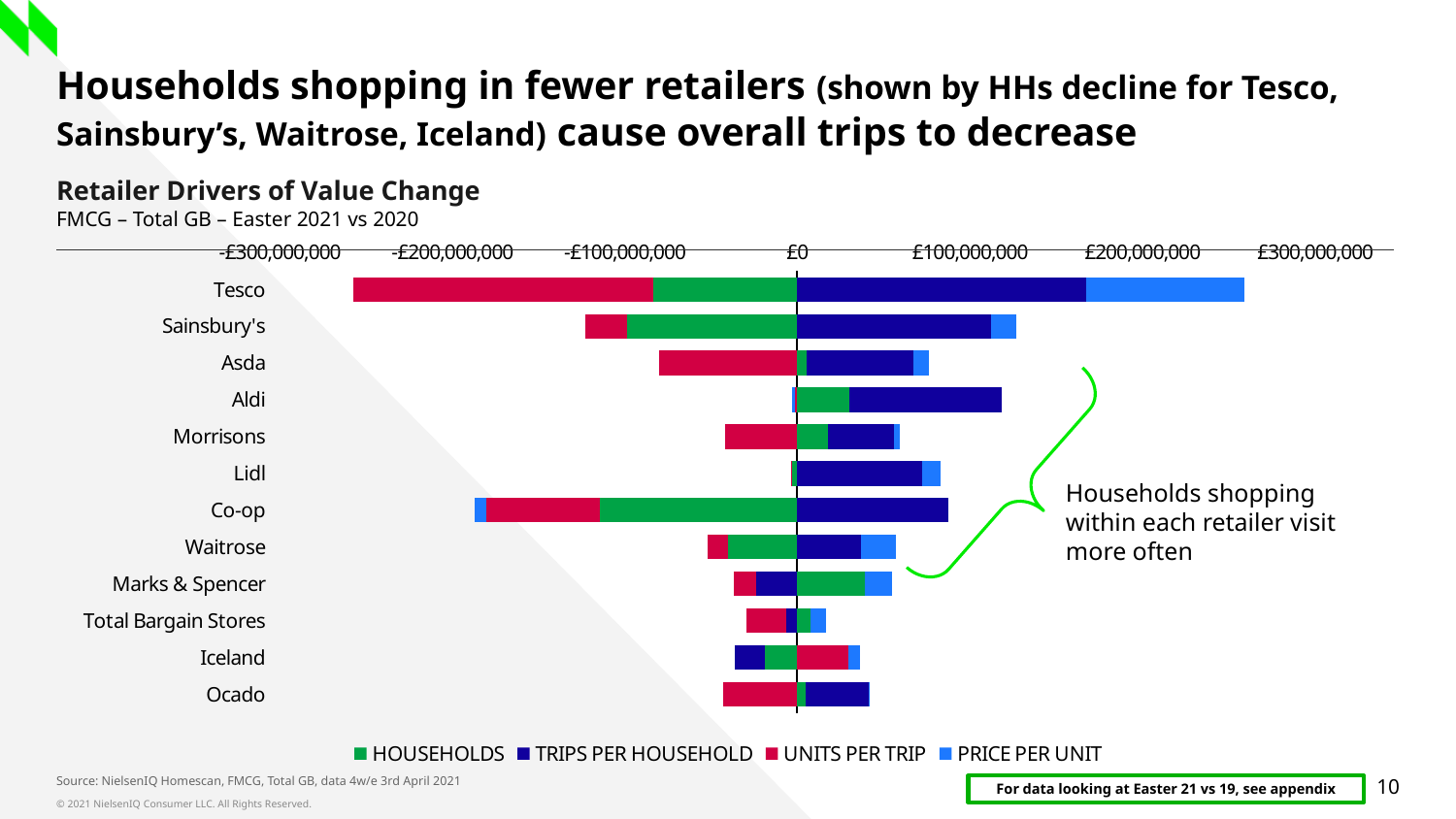
Which retailer has the largest negative Households segment? Co-op What is the title of the chart? Retailer Drivers of Value Change Is the Units per Trip value for Tesco greater or less than -£100,000,000? less Which series is shown in green in the legend? HOUSEHOLDS Which retailer is listed first (at the top) on the chart? Tesco What kind of chart is shown on the slide? Stacked horizontal bar chart How many series does the legend list? 4 Which has the larger Trips per Household segment, Tesco or Ocado? Tesco Which retailer has the largest Trips per Household segment? Tesco How many retailers are listed on the chart? 12 Is the Households value for Co-op greater or less than -£100,000,000? less Is the Trips per Household value for Tesco greater or less than £100,000,000? greater